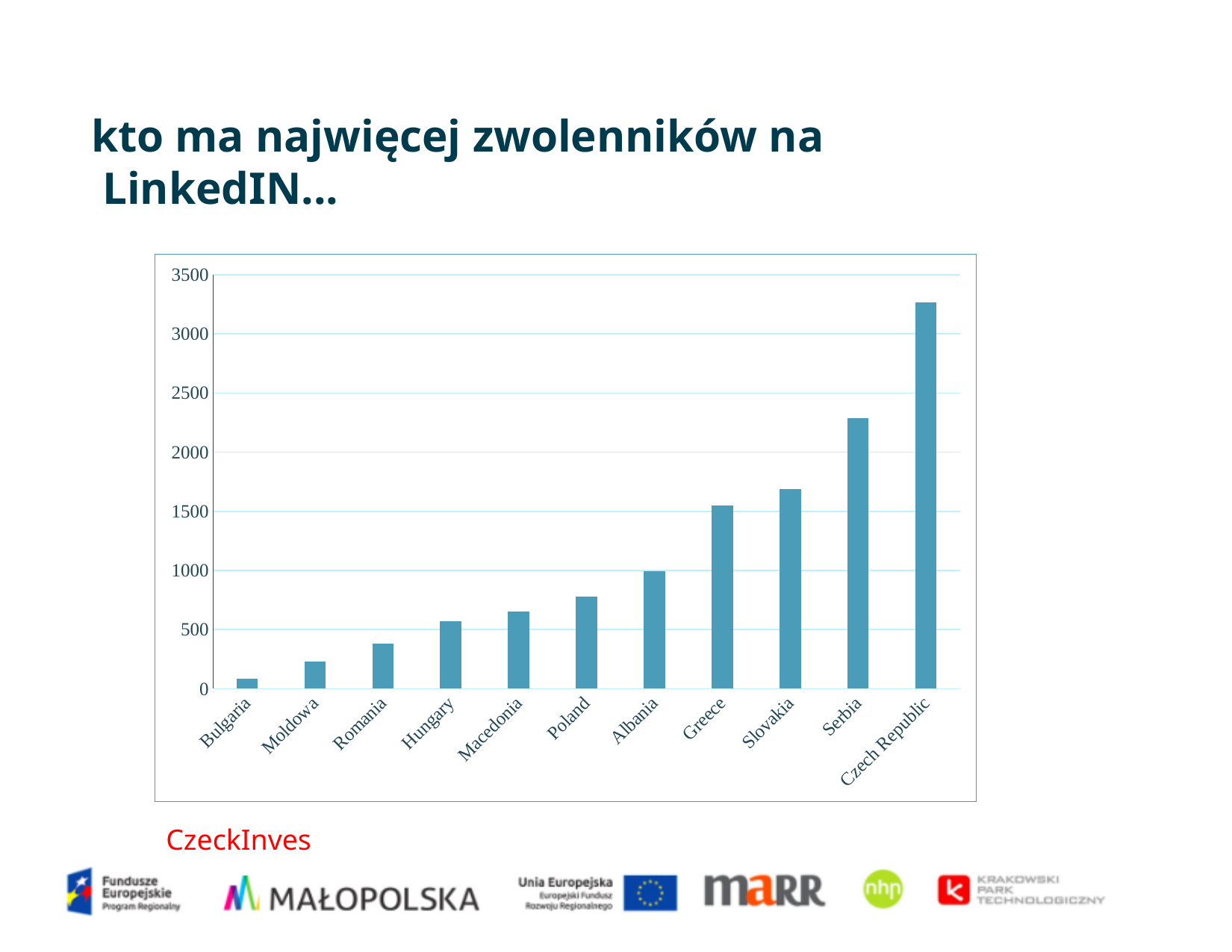
How many countries are shown on the x axis of the chart? 11 Is the value for Romania greater or less than 500? less Is the value for Czech Republic greater or less than 3000? greater Is the value for Macedonia greater or less than 500? greater Which has a larger value, Serbia or Slovakia? Serbia Do the bar values rise or fall from left to right along the x axis? rise What is the highest value shown on the vertical axis of the chart? 3500 Which country has the lowest bar in the chart? Bulgaria Which country has the highest bar in the chart? Czech Republic What kind of chart is shown on the slide? bar chart